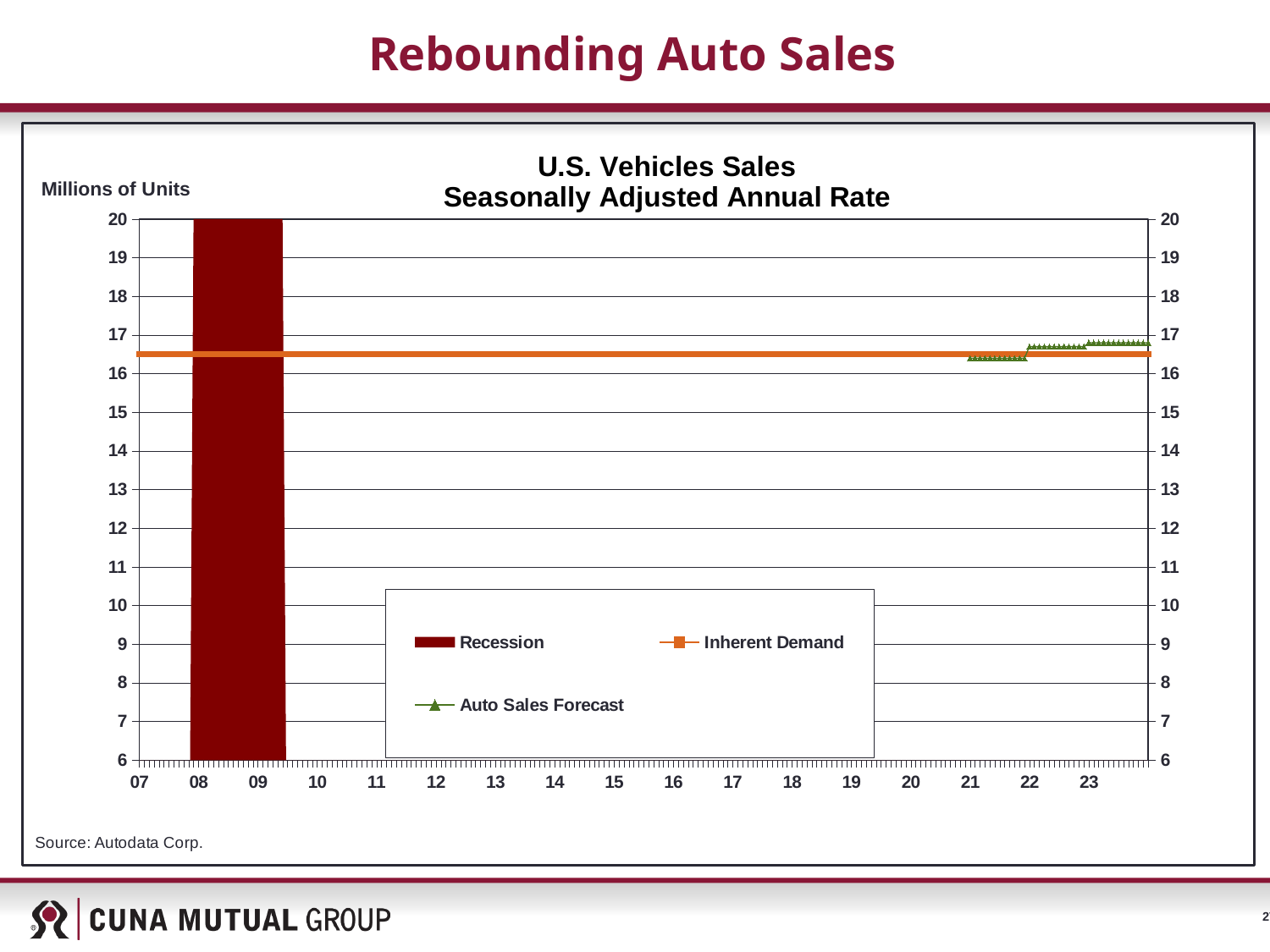
How many series does the chart legend list? 3 Does the Auto Sales Forecast line rise or fall from 21 to 23? rise Is the value of the Inherent Demand line greater or less than 17? less Does the Inherent Demand line rise, fall, or stay flat across the years shown? stay flat Is the Auto Sales Forecast value in 21 greater or less than 16? greater Which years does the Recession bar cover on the x axis? 08 and 09 In 23, which is higher: the Auto Sales Forecast or Inherent Demand? Auto Sales Forecast Is the value of the Inherent Demand line greater or less than 16? greater What is the title of the chart? U.S. Vehicles Sales Seasonally Adjusted Annual Rate How many year labels are shown on the x axis? 17 What unit is shown on the vertical axis of the chart? Millions of Units